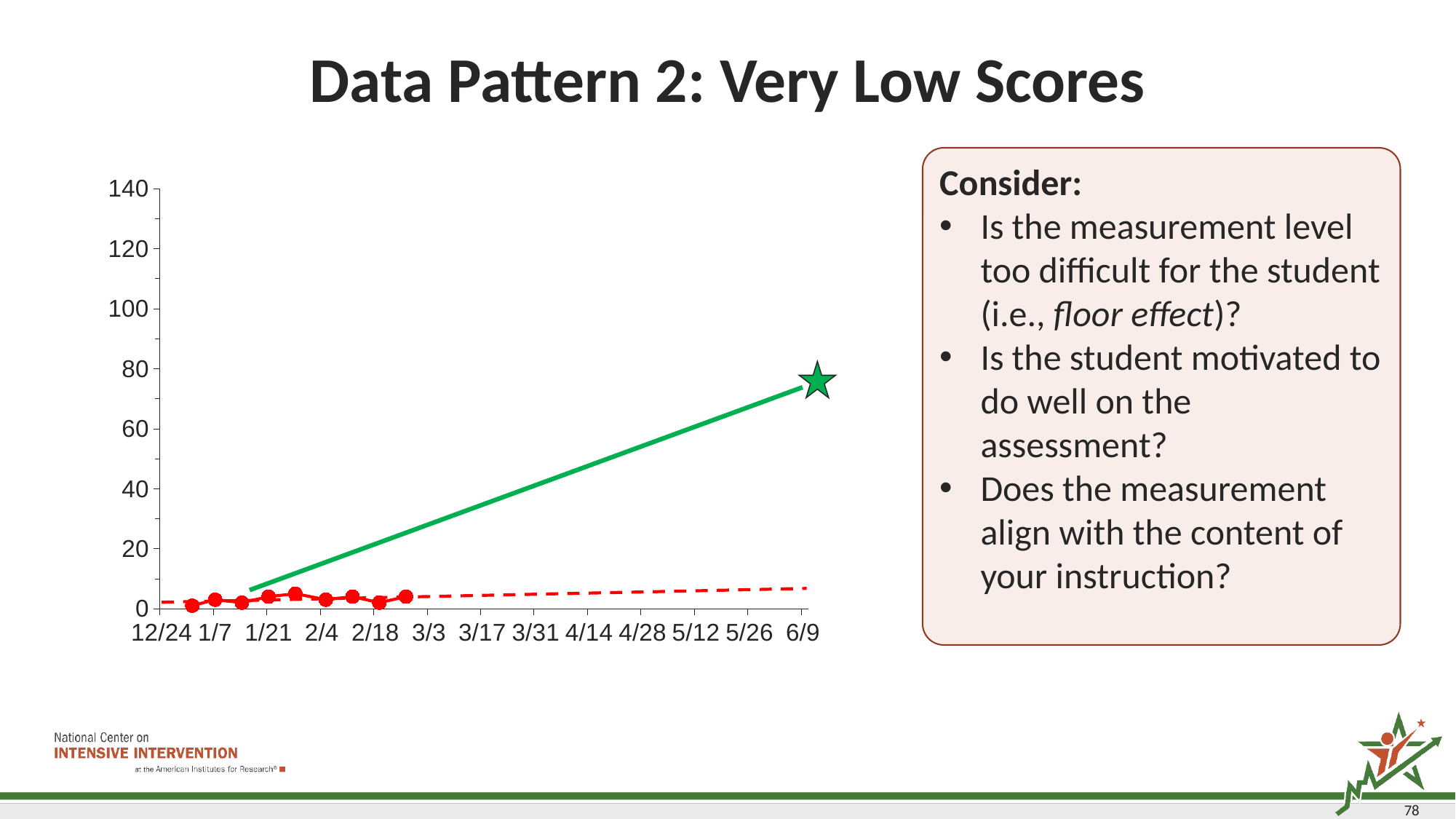
What is the title of the slide containing the chart? Data Pattern 2: Very Low Scores Is the value of the student's score on 1/7 greater or less than 20? less Do the red plotted student scores show a strong rise, a strong fall, or stay roughly flat over time? roughly flat What is the first date label on the x axis? 12/24 Does the solid green goal line rise or fall from left to right? rise Is the value at the star marker at the end of the green goal line greater or less than 100? less Is the value of the student's score on 2/18 greater or less than 20? less What is the highest value shown on the y axis? 140 How many date labels are shown along the x axis? 13 What kind of chart is shown on the slide? line chart